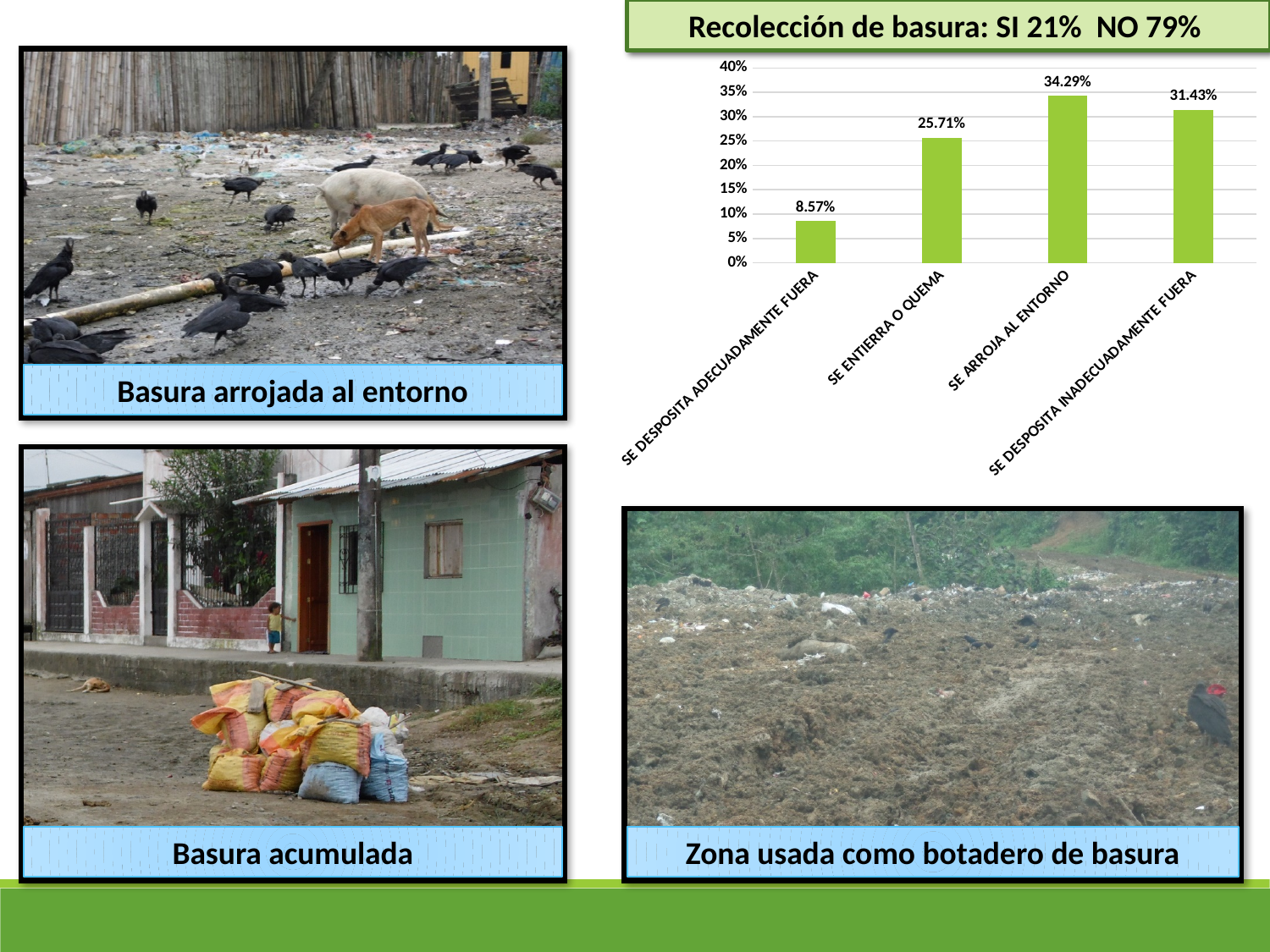
Which category has the lowest value? SE DESPOSITA ADECUADAMENTE FUERA What is the value for SE DESPOSITA ADECUADAMENTE FUERA? 8.57% How many categories are shown in the bar chart? 4 What is the title shown above the chart? Recolección de basura: SI 21% NO 79% Which is larger, SE ENTIERRA O QUEMA or SE DESPOSITA INADECUADAMENTE FUERA? SE DESPOSITA INADECUADAMENTE FUERA Is the value for SE ENTIERRA O QUEMA greater or less than 30%? less What is the difference between SE ARROJA AL ENTORNO and SE DESPOSITA ADECUADAMENTE FUERA? 25.72% What is the value for SE DESPOSITA INADECUADAMENTE FUERA? 31.43% Which category has the highest value? SE ARROJA AL ENTORNO What kind of chart is shown on the slide? bar chart What is the value for SE ARROJA AL ENTORNO? 34.29% What is the value for SE ENTIERRA O QUEMA? 25.71%